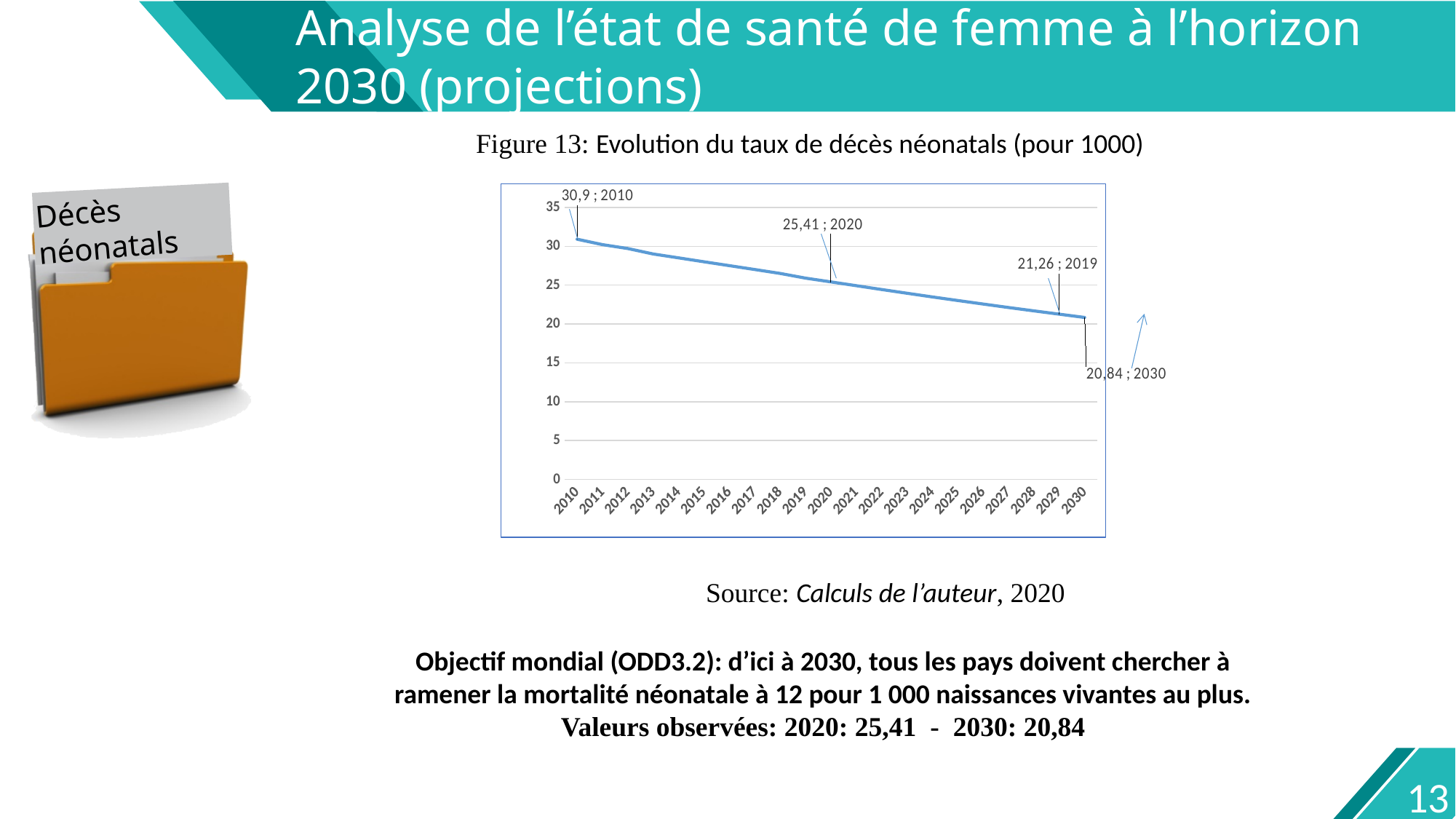
What is the neonatal death rate shown for 2010? 30,9 What is the neonatal death rate shown for 2020? 25,41 Which year has the highest neonatal death rate on the chart? 2010 Which year has the higher neonatal death rate, 2010 or 2030? 2010 What is the neonatal death rate shown for 2030? 20,84 Does the neonatal death rate rise or fall from 2010 to 2030? fall By how much does the neonatal death rate decrease between 2010 and 2030? 10,06 What kind of chart is Figure 13? line chart Is the value for 2015 greater or less than 25? greater How many years are shown on the x axis of the chart? 21 Which year has the lowest neonatal death rate on the chart? 2030 What is the difference between the 2020 value and the 2030 value? 4,57